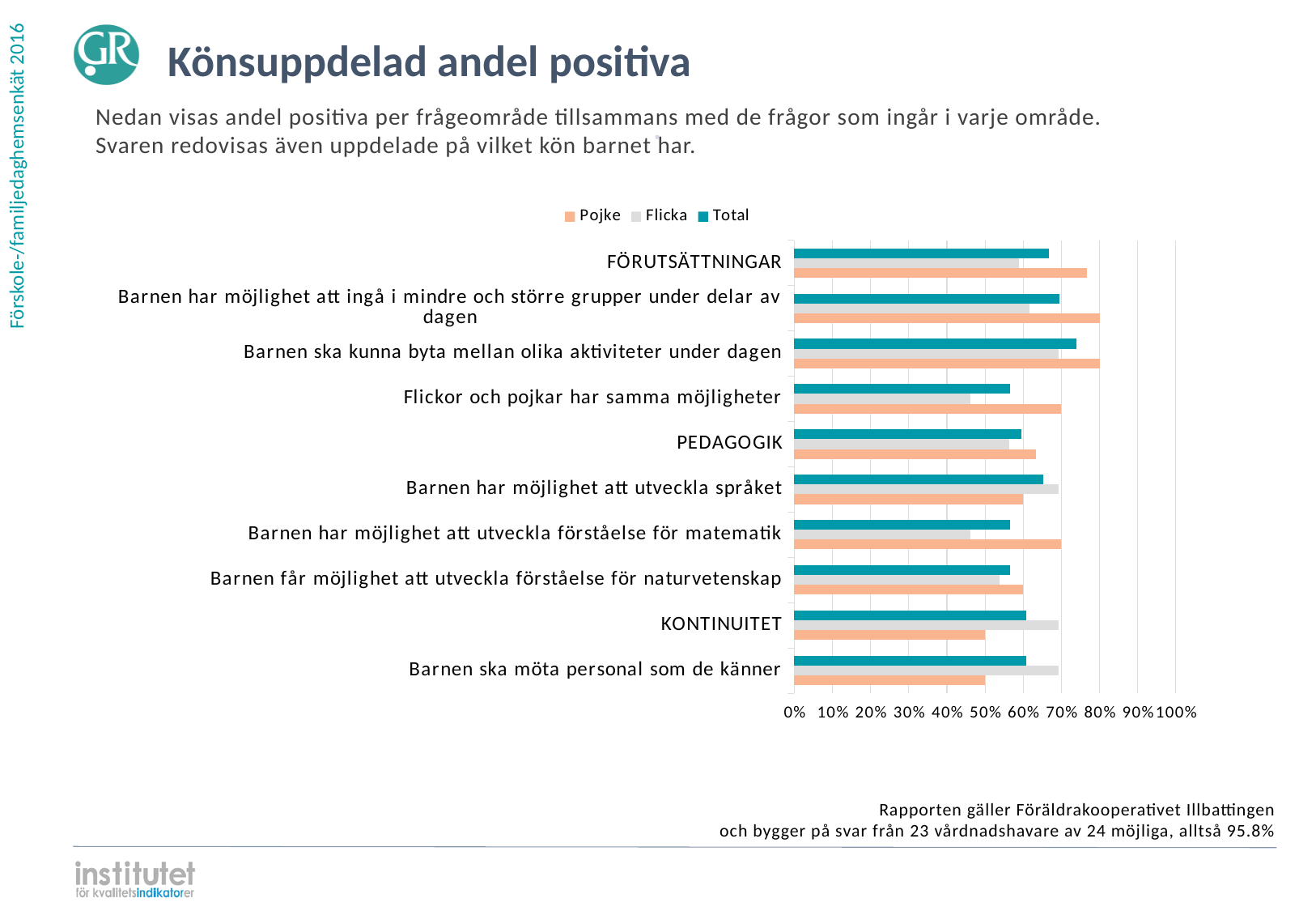
For KONTINUITET, which is larger: the Flicka value or the Pojke value? Flicka For 'Barnen har möjlighet att utveckla språket', which series has the highest value? Flicka Is the Pojke value for KONTINUITET greater or less than 60%? less Which series are listed in the legend? Pojke, Flicka, Total Is the Pojke value for 'Flickor och pojkar har samma möjligheter' greater or less than 60%? greater Is the Flicka value for 'Flickor och pojkar har samma möjligheter' greater or less than 50%? less What kind of chart is shown on the slide? bar chart How many series does the legend list? 3 What is the title of the slide containing the chart? Könsuppdelad andel positiva For 'Flickor och pojkar har samma möjligheter', which is larger: the Pojke value or the Flicka value? Pojke How many categories are plotted on the chart? 10